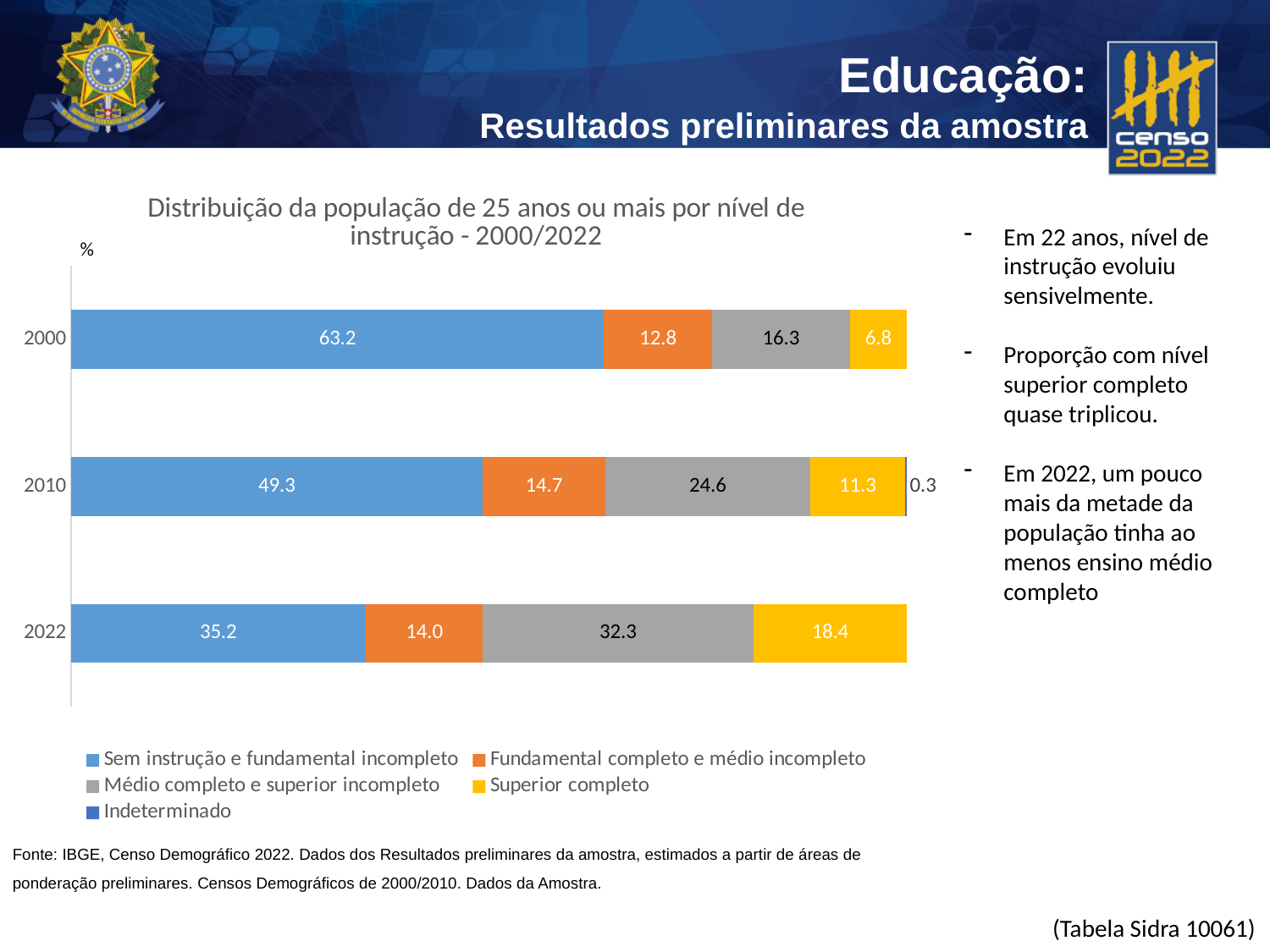
What is the value for "Médio completo e superior incompleto" in 2010? 24.6 What is the value for "Superior completo" in 2022? 18.4 By how much did the value for "Superior completo" increase from 2000 to 2022? 11.6 What is the value for "Sem instrução e fundamental incompleto" in 2000? 63.2 How many years are shown on the chart? 3 In 2010, which is larger: "Médio completo e superior incompleto" or "Fundamental completo e médio incompleto"? Médio completo e superior incompleto Does the value for "Sem instrução e fundamental incompleto" rise or fall from 2000 to 2022? Fall What is the value for "Indeterminado" in 2010? 0.3 What kind of chart is shown on the slide? Stacked bar chart In which year is the value for "Superior completo" highest? 2022 In which year is the value for "Sem instrução e fundamental incompleto" lowest? 2022 How many series does the legend list? 5